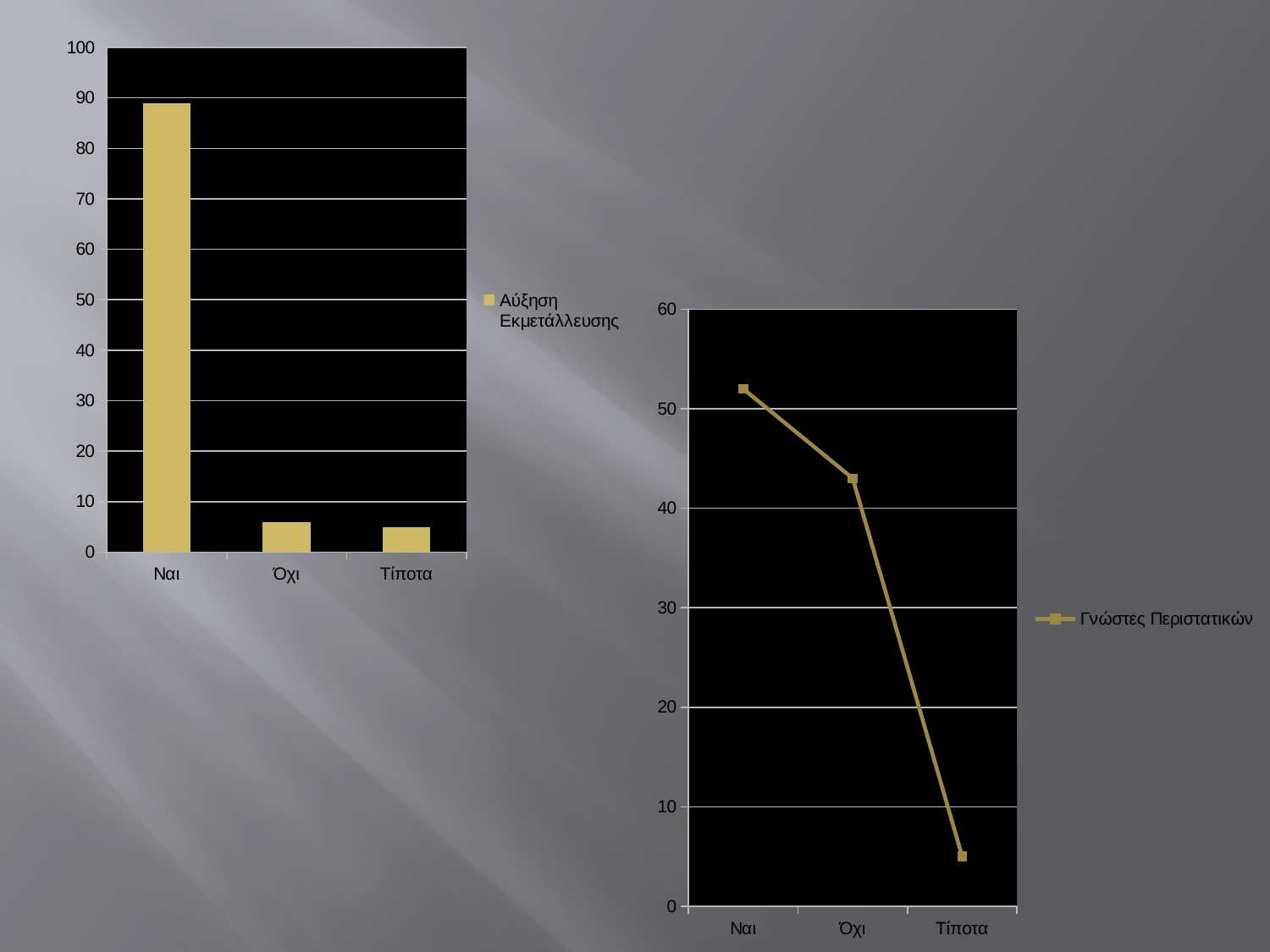
In the bar chart on the left, is the value for Όχι greater or less than 10? less In the line chart on the right, do the values rise or fall from Ναι to Τίποτα? fall In the line chart on the right, how many series does the legend list? 1 In the line chart on the right, is the value for Όχι greater or less than 40? greater In the line chart on the right, which category has the lowest value? Τίποτα In the bar chart on the left, which category has the highest value? Ναι What kind of chart is the chart on the left of the slide? bar chart In the bar chart on the left, is the value for Ναι greater or less than 80? greater In the bar chart on the left, what series name does the legend show? Αύξηση Εκμετάλλευσης In the bar chart on the left, how many categories are shown on the x axis? 3 What kind of chart is the chart on the right of the slide? line chart